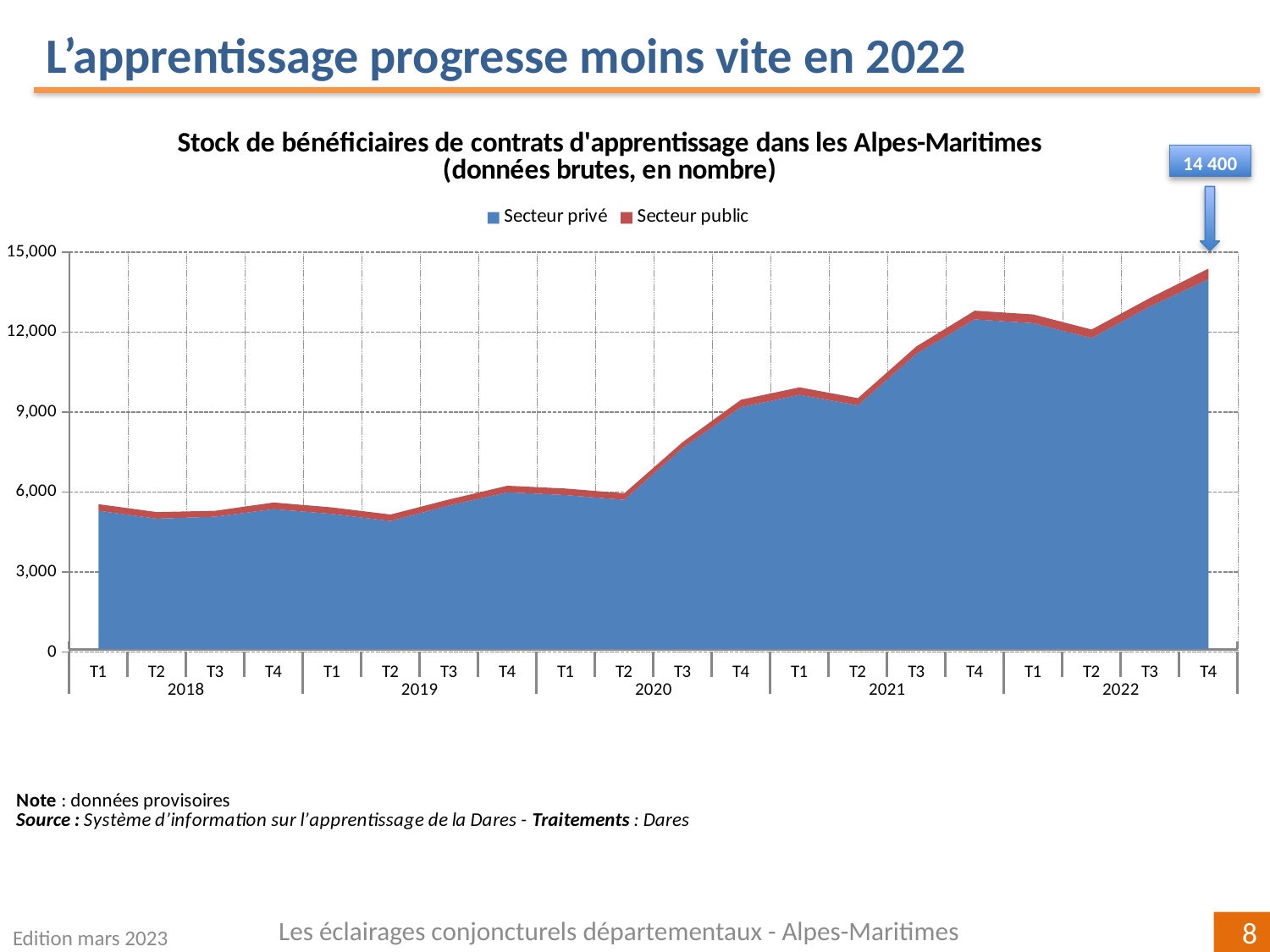
Is the total value for T4 2021 greater or less than 12,000? greater What is the total stock of apprenticeship contract beneficiaries in T4 2022, as annotated on the chart? 14 400 Is the total value for T1 2018 greater or less than 6,000? less How many quarterly data points are plotted along the x axis? 20 Overall, do the values rise or fall from 2018 to 2022? rise Which quarter has the highest total stock of beneficiaries? T4 2022 What kind of chart is shown on the slide? area chart Is the total value for T1 2021 greater or less than 9,000? greater What are the two series named in the legend? Secteur privé and Secteur public Which is larger, the total for T4 2021 or the total for T2 2022? T4 2021 Which series accounts for the larger share of the stacked area, Secteur privé or Secteur public? Secteur privé How many series does the legend list? 2